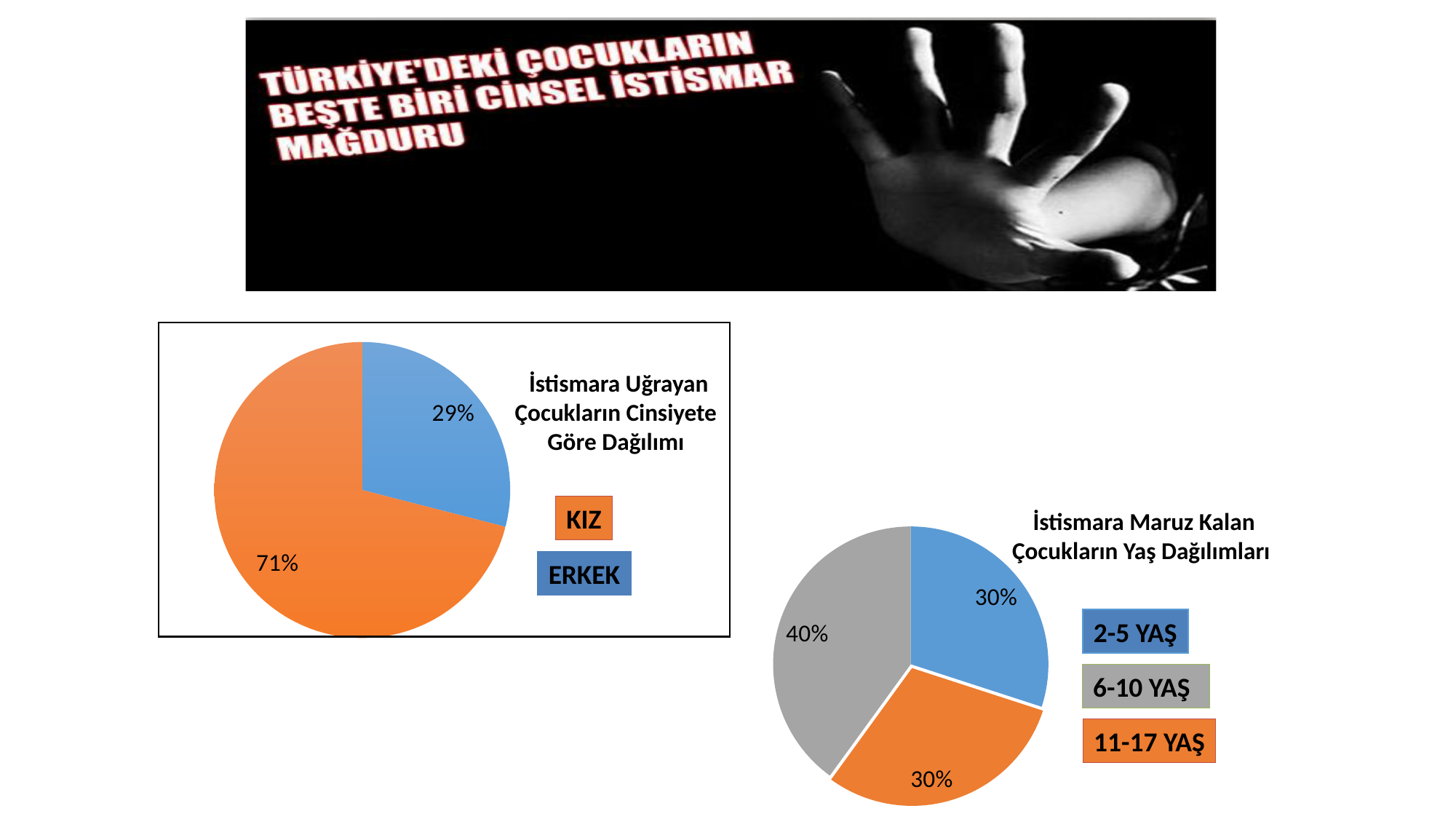
In the chart titled 'İstismara Maruz Kalan Çocukların Yaş Dağılımları', what colour represents 6-10 YAŞ? Grey In the chart titled 'İstismara Maruz Kalan Çocukların Yaş Dağılımları', what share is shown for 6-10 YAŞ? 40% In the chart titled 'İstismara Maruz Kalan Çocukların Yaş Dağılımları', which age group has the largest slice? 6-10 YAŞ In the chart titled 'İstismara Uğrayan Çocukların Cinsiyete Göre Dağılımı', what is the difference in percentage points between KIZ and ERKEK? 42 percentage points In the chart titled 'İstismara Uğrayan Çocukların Cinsiyete Göre Dağılımı', what share is shown for KIZ? 71% In the chart titled 'İstismara Uğrayan Çocukların Cinsiyete Göre Dağılımı', which category has the larger slice? KIZ In the chart titled 'İstismara Uğrayan Çocukların Cinsiyete Göre Dağılımı', what share is shown for ERKEK? 29% In the chart titled 'İstismara Maruz Kalan Çocukların Yaş Dağılımları', what is the difference in percentage points between 6-10 YAŞ and 2-5 YAŞ? 10 percentage points In the chart titled 'İstismara Maruz Kalan Çocukların Yaş Dağılımları', what share is shown for 2-5 YAŞ? 30% In the chart titled 'İstismara Maruz Kalan Çocukların Yaş Dağılımları', what share is shown for 11-17 YAŞ? 30% What kind of chart is the one titled 'İstismara Uğrayan Çocukların Cinsiyete Göre Dağılımı'? Pie chart How many slices does the chart titled 'İstismara Maruz Kalan Çocukların Yaş Dağılımları' have? 3